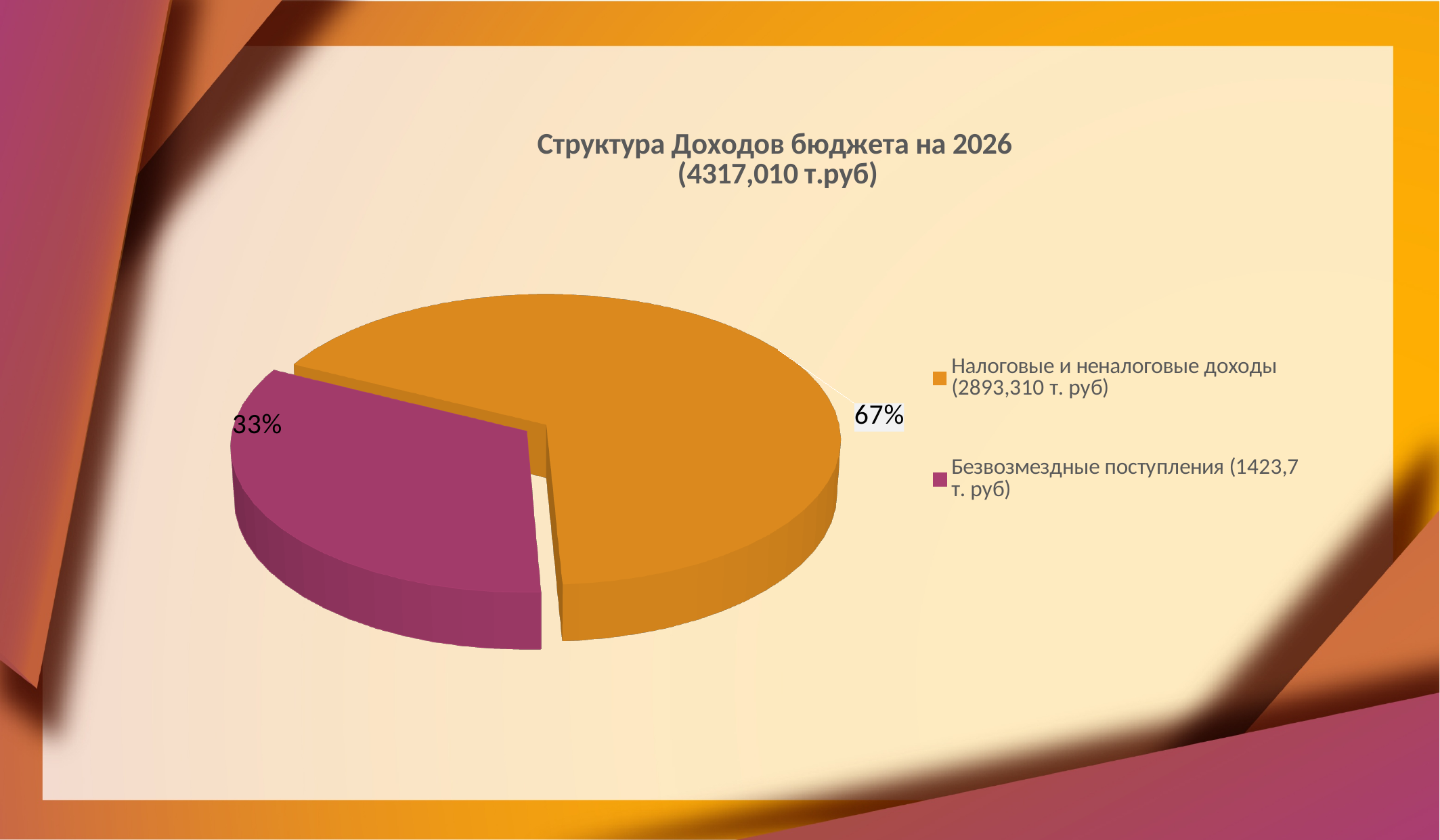
What amount is given in the legend for 'Налоговые и неналоговые доходы'? 2893,310 т. руб What share of the pie does 'Безвозмездные поступления' take? 33% What is the title of the chart? Структура Доходов бюджета на 2026 (4317,010 т.руб) What colour is the slice for 'Безвозмездные поступления'? magenta (purple-pink) How many slices does the pie chart have? 2 By how many percentage points does the share of 'Налоговые и неналоговые доходы' exceed that of 'Безвозмездные поступления'? 34 percentage points Which is larger: the share for 'Налоговые и неналоговые доходы' or the share for 'Безвозмездные поступления'? Налоговые и неналоговые доходы What share of the pie does 'Налоговые и неналоговые доходы' take? 67% What kind of chart is shown on the slide? pie chart Which category has the largest share of the pie? Налоговые и неналоговые доходы What amount is given in the legend for 'Безвозмездные поступления'? 1423,7 т. руб Which category has the smallest share of the pie? Безвозмездные поступления